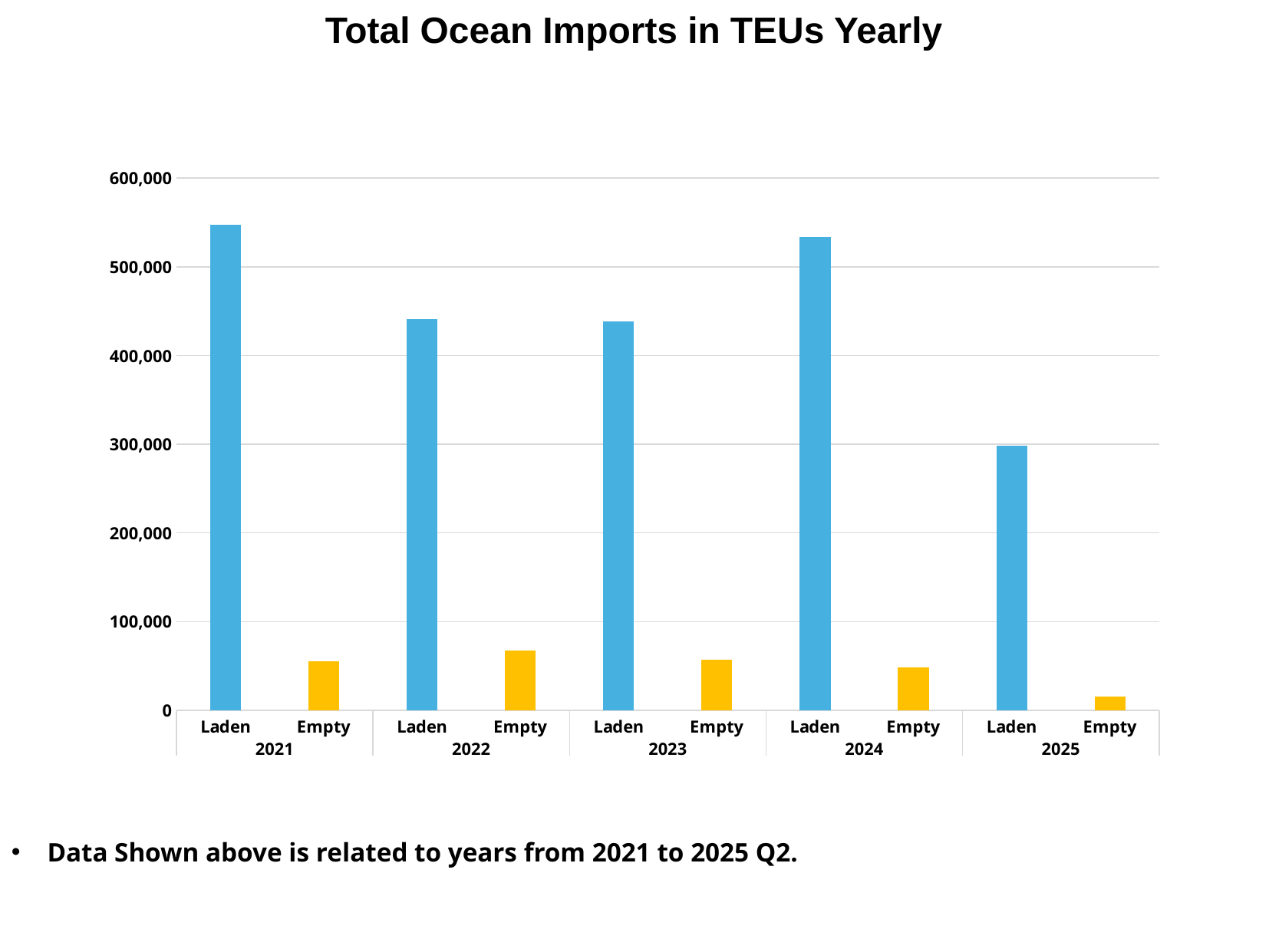
What is the title of the chart? Total Ocean Imports in TEUs Yearly What type of chart is shown on the slide? bar chart Which year has the highest Laden value? 2021 Is the Empty value for 2022 greater or less than 100,000? less Is the Laden value for 2025 greater or less than 400,000? less Which year has the highest Empty value? 2022 Which year has the lowest Empty value? 2025 Which is larger, the Laden value for 2024 or the Laden value for 2023? 2024 Is the Laden value for 2021 greater or less than 500,000? greater How many years are shown on the x axis of the chart? 5 How many bars are plotted in the chart in total? 10 Which year has the lowest Laden value? 2025